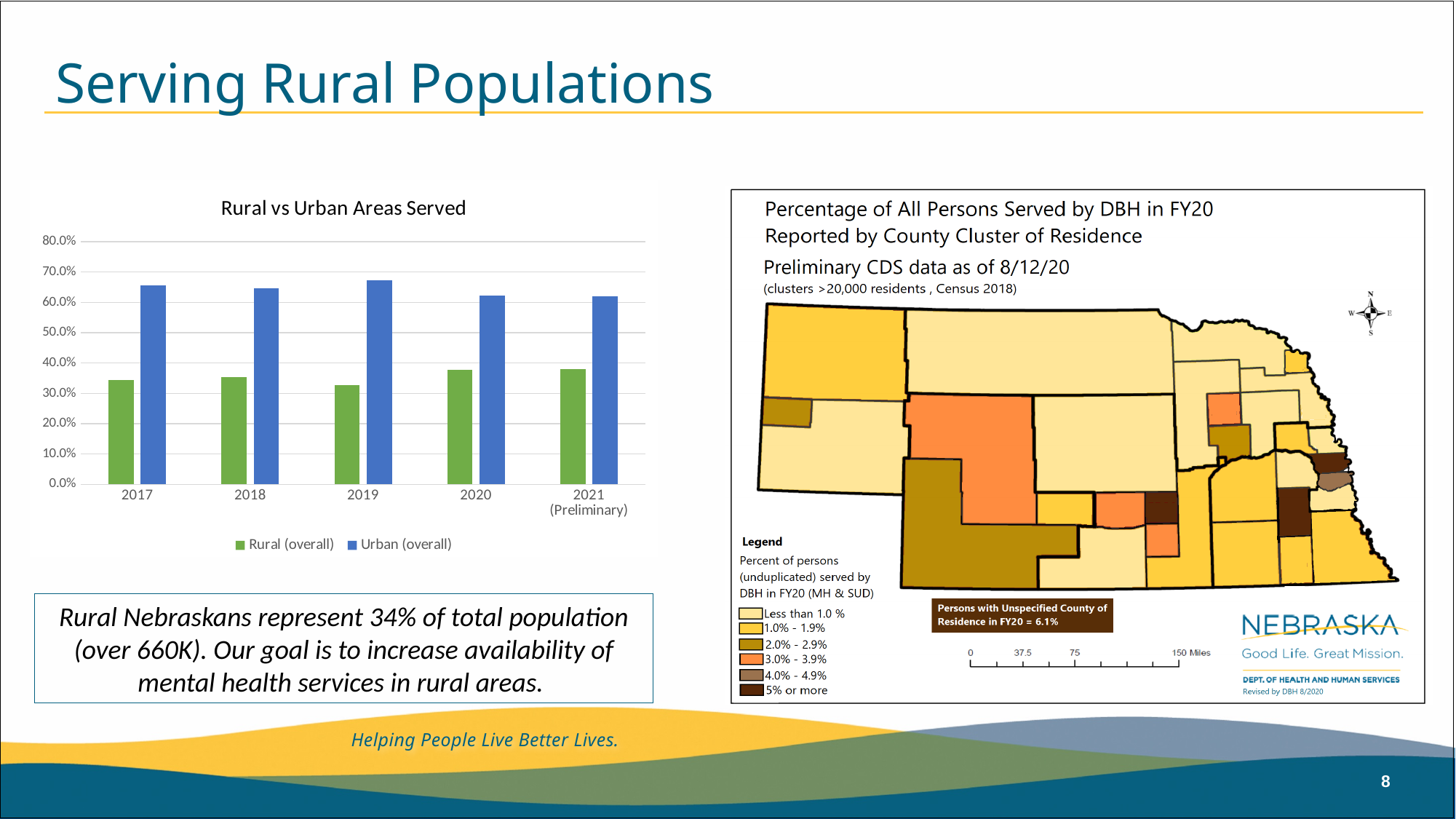
In the "Rural vs Urban Areas Served" chart, which colour represents the Urban (overall) series? blue In the "Rural vs Urban Areas Served" chart, which is larger in 2017: Rural (overall) or Urban (overall)? Urban (overall) In the "Rural vs Urban Areas Served" chart, which year has the highest Urban (overall) value? 2019 In the "Rural vs Urban Areas Served" chart, is the Rural (overall) value for 2019 greater or less than 30.0%? greater In the "Rural vs Urban Areas Served" chart, is the Rural (overall) value larger in 2019 or in 2020? 2020 In the "Rural vs Urban Areas Served" chart, is the Urban (overall) value for 2020 greater or less than 70.0%? less How many series does the legend of the "Rural vs Urban Areas Served" chart list? 2 In the "Rural vs Urban Areas Served" chart, is the Urban (overall) value for 2019 greater or less than 60.0%? greater How many years are shown on the x axis of the "Rural vs Urban Areas Served" chart? 5 What kind of chart is "Rural vs Urban Areas Served"? bar chart What is the title of the bar chart on the left of the slide? Rural vs Urban Areas Served